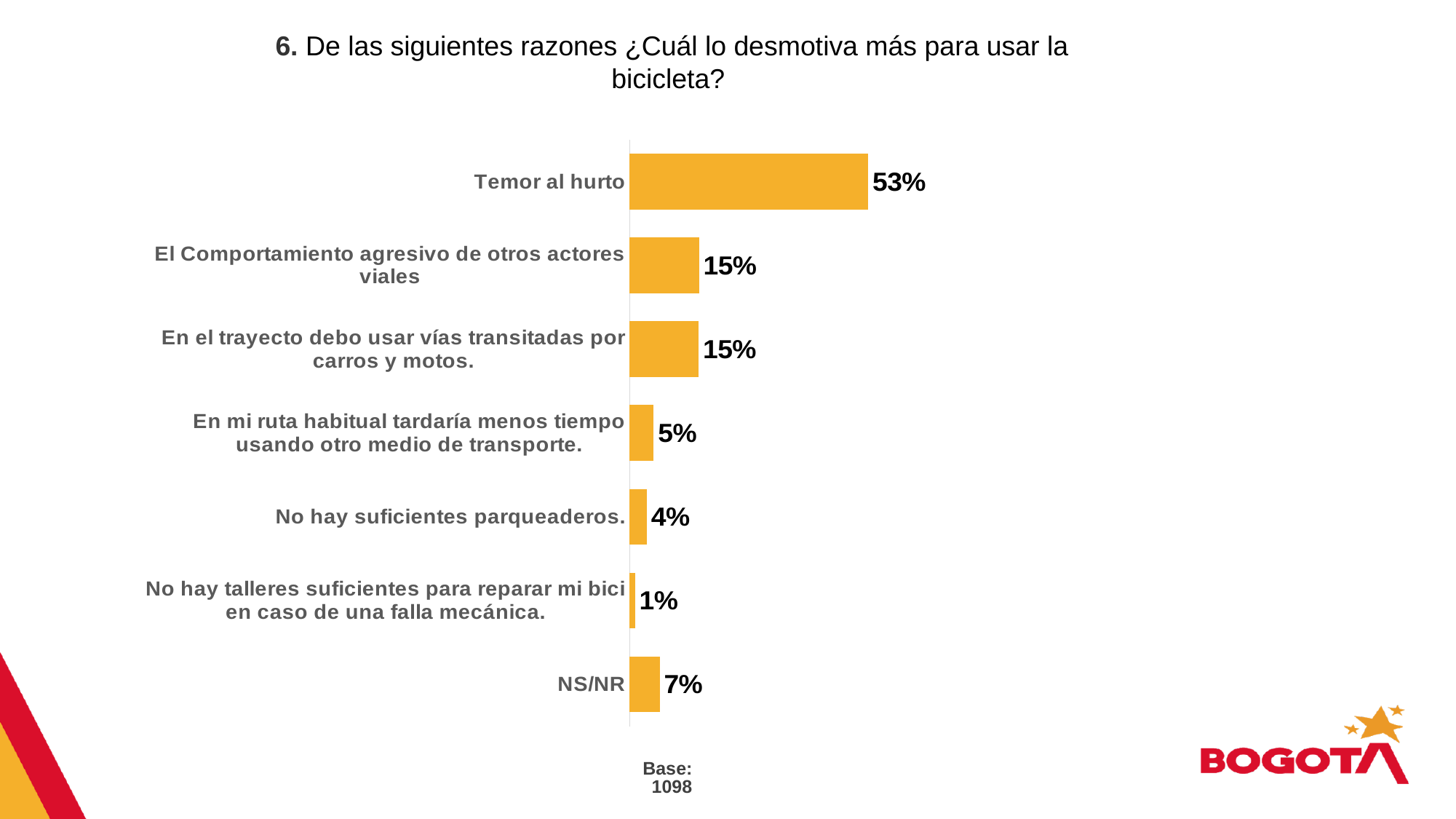
Which is larger: the value for "NS/NR" or the value for "No hay suficientes parqueaderos."? NS/NR How many categories are shown in the chart? 7 Which category has the highest value? Temor al hurto What kind of chart is shown on the slide? Bar chart What is the difference between the values for "Temor al hurto" and "El Comportamiento agresivo de otros actores viales"? 38% What colour are the bars in the chart? Orange/yellow What percentage is shown for "En mi ruta habitual tardaría menos tiempo usando otro medio de transporte."? 5% What percentage is shown for "No hay suficientes parqueaderos."? 4% Which category has the lowest value? No hay talleres suficientes para reparar mi bici en caso de una falla mecánica. What percentage is shown for "Temor al hurto"? 53% What is the base (number of respondents) shown below the chart? 1098 What percentage is shown for "NS/NR"? 7%